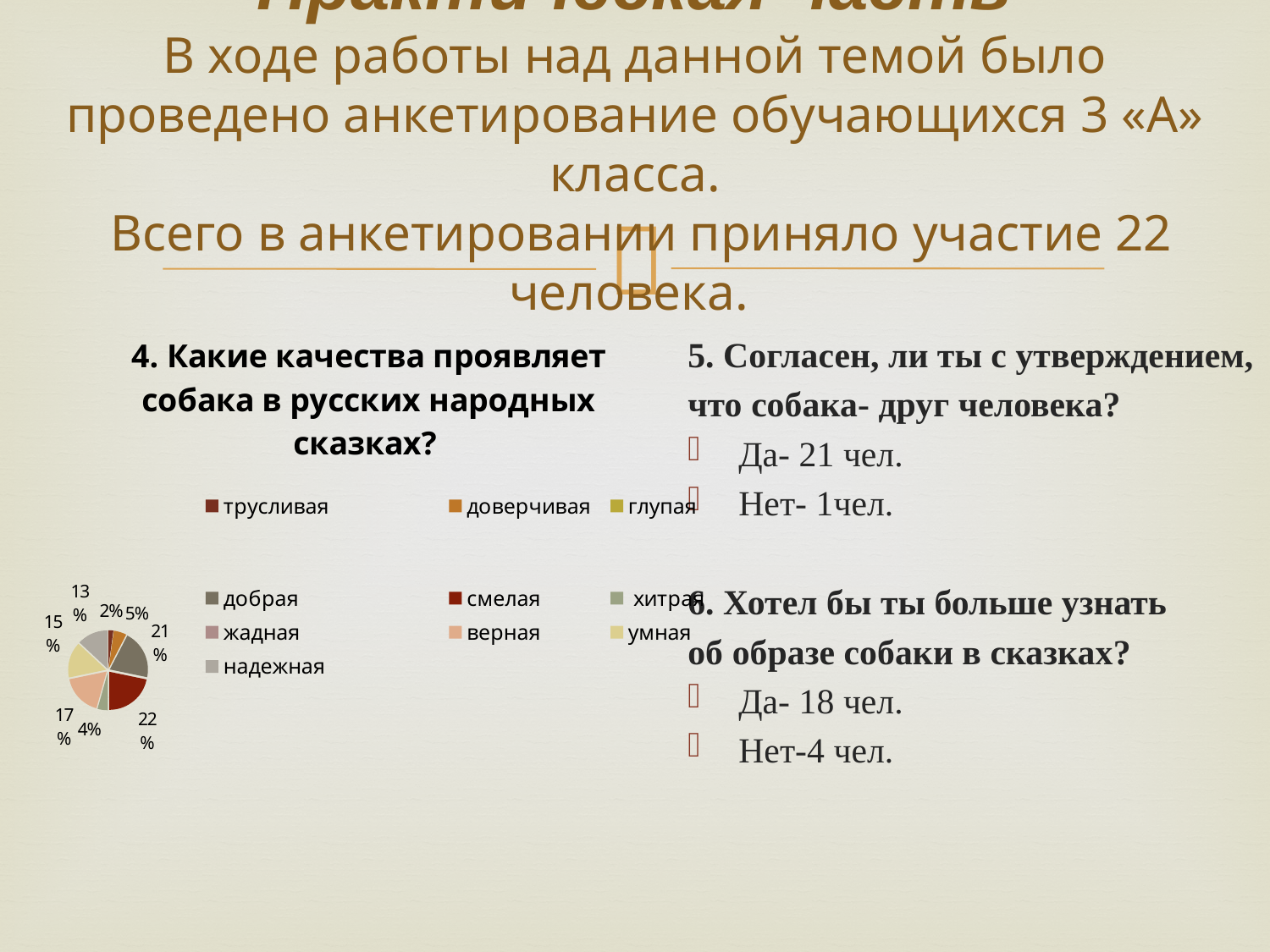
What is the largest percentage label shown on the pie chart? 22% What kind of chart is shown on the slide? pie chart What is the title of the pie chart? 4. Какие качества проявляет собака в русских народных сказках? Which legend entry is listed first in the pie chart's legend? трусливая How many entries does the legend of the pie chart list? 10 What is the difference between the largest and smallest percentage labels on the pie chart? 20% How many percentage data labels are printed around the pie chart? 8 Is the largest slice of the pie chart greater or less than 20%? greater What is the smallest percentage label shown on the pie chart? 2%